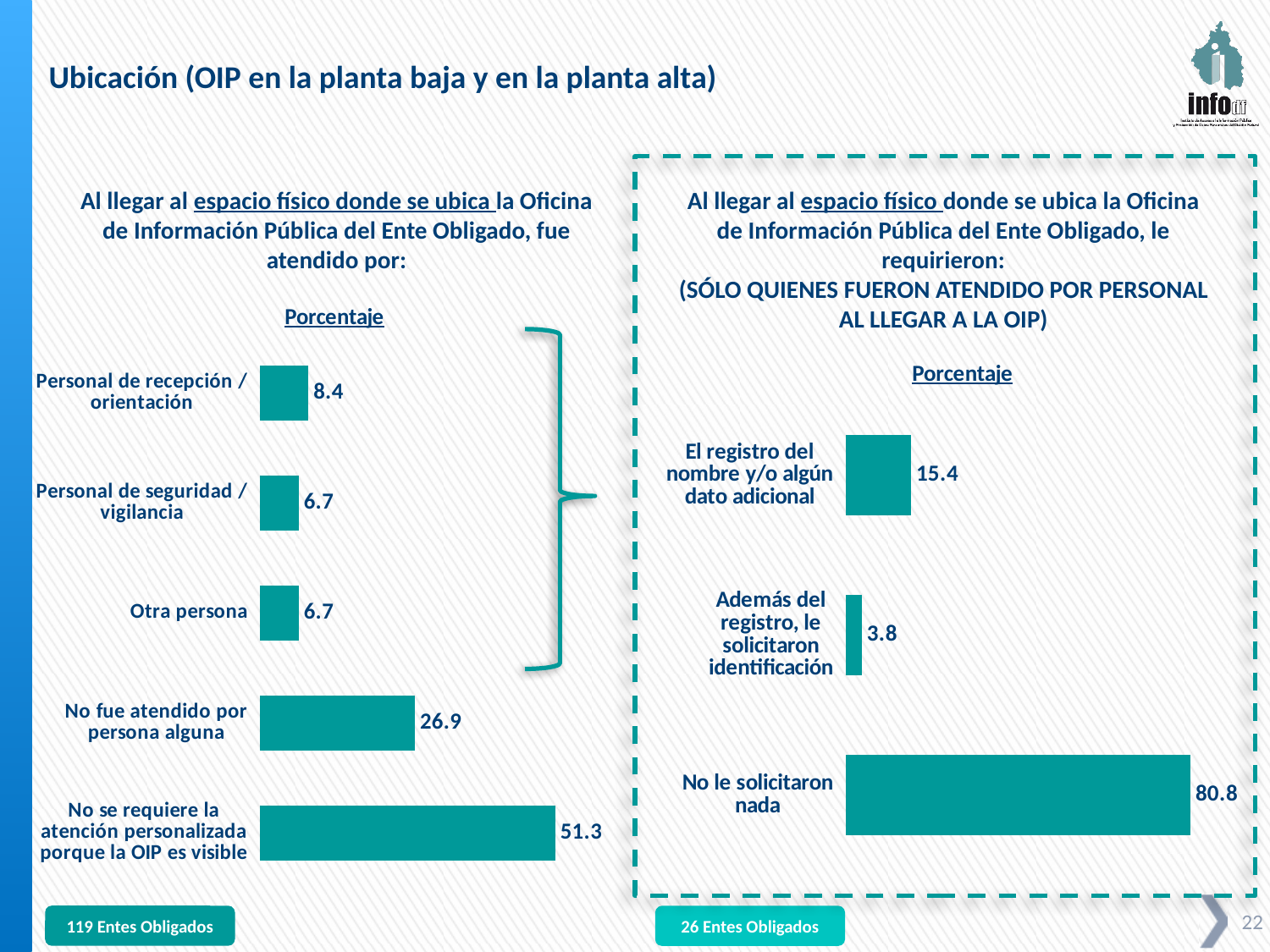
In the right chart, what is the value for "Además del registro, le solicitaron identificación"? 3.8 How many categories does the left chart show? 5 In the left chart, what is the value for "Personal de recepción / orientación"? 8.4 In the left chart, which is larger: "Personal de recepción / orientación" or "Personal de seguridad / vigilancia"? Personal de recepción / orientación In the left chart, what is the difference between "No se requiere la atención personalizada porque la OIP es visible" and "No fue atendido por persona alguna"? 24.4 In the right chart, what is the value for "No le solicitaron nada"? 80.8 In the right chart, what is the difference between "El registro del nombre y/o algún dato adicional" and "Además del registro, le solicitaron identificación"? 11.6 What type of chart is the right chart? Bar chart How many categories does the right chart show? 3 In the left chart, which category has the highest value? No se requiere la atención personalizada porque la OIP es visible In the right chart, which category has the lowest value? Además del registro, le solicitaron identificación In the left chart, what is the value for "No fue atendido por persona alguna"? 26.9